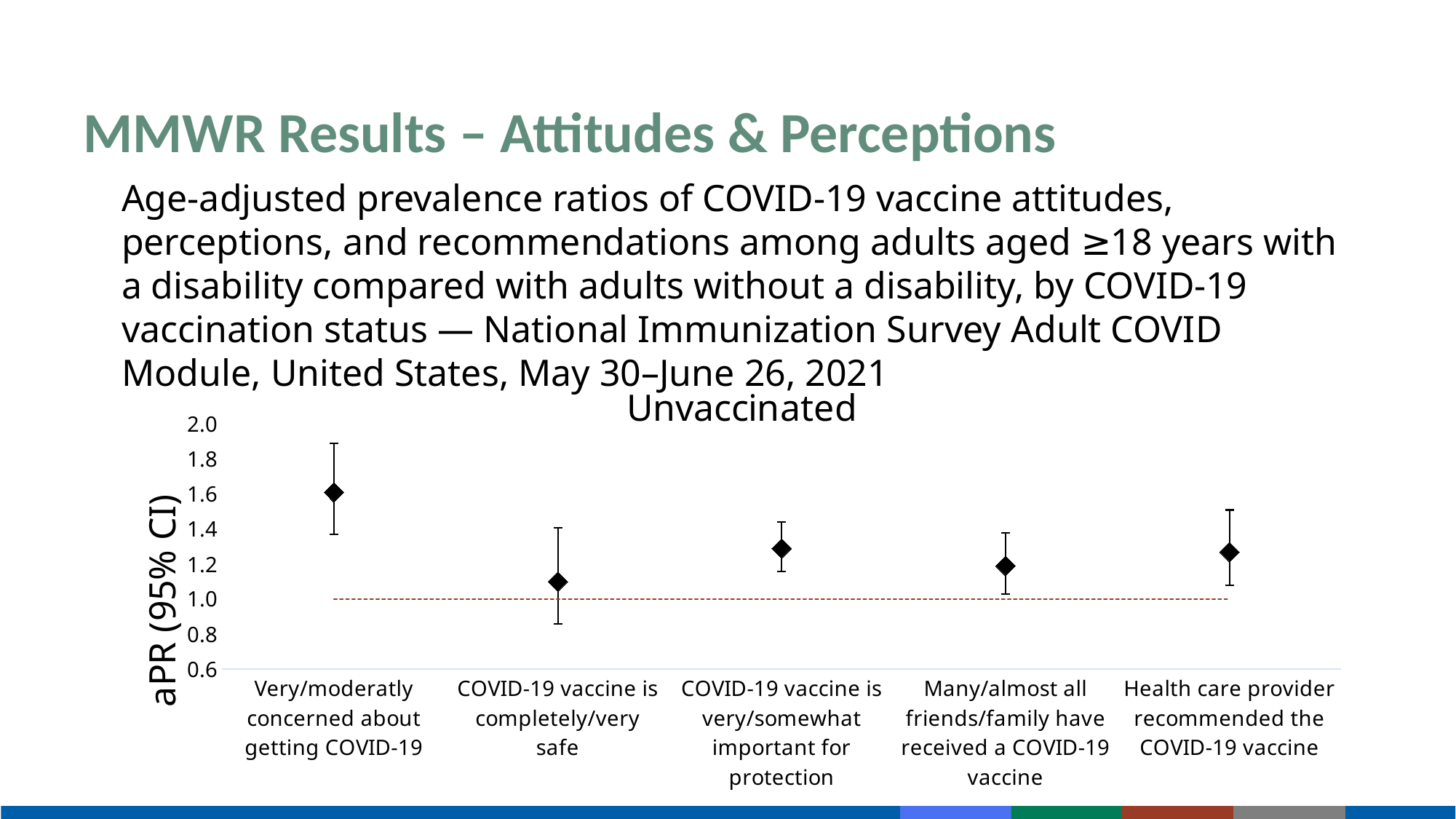
Is the aPR for 'Very/moderately concerned about getting COVID-19' greater or less than 1.4? greater What is the label on the y axis of the chart? aPR (95% CI) Is the aPR for 'COVID-19 vaccine is completely/very safe' greater or less than 1.2? less Is the aPR for 'Health care provider recommended the COVID-19 vaccine' greater or less than 1.0? greater Which has a higher aPR: 'COVID-19 vaccine is very/somewhat important for protection' or 'COVID-19 vaccine is completely/very safe'? COVID-19 vaccine is very/somewhat important for protection Which has a higher aPR: 'Very/moderately concerned about getting COVID-19' or 'Health care provider recommended the COVID-19 vaccine'? Very/moderately concerned about getting COVID-19 Which category has the highest aPR in the chart? Very/moderately concerned about getting COVID-19 What kind of chart is shown on the slide? A point (scatter) chart with error bars Which category has the lowest aPR in the chart? COVID-19 vaccine is completely/very safe How many attitude/perception categories are plotted on the x axis of the chart? 5 What is the title of the chart? Unvaccinated